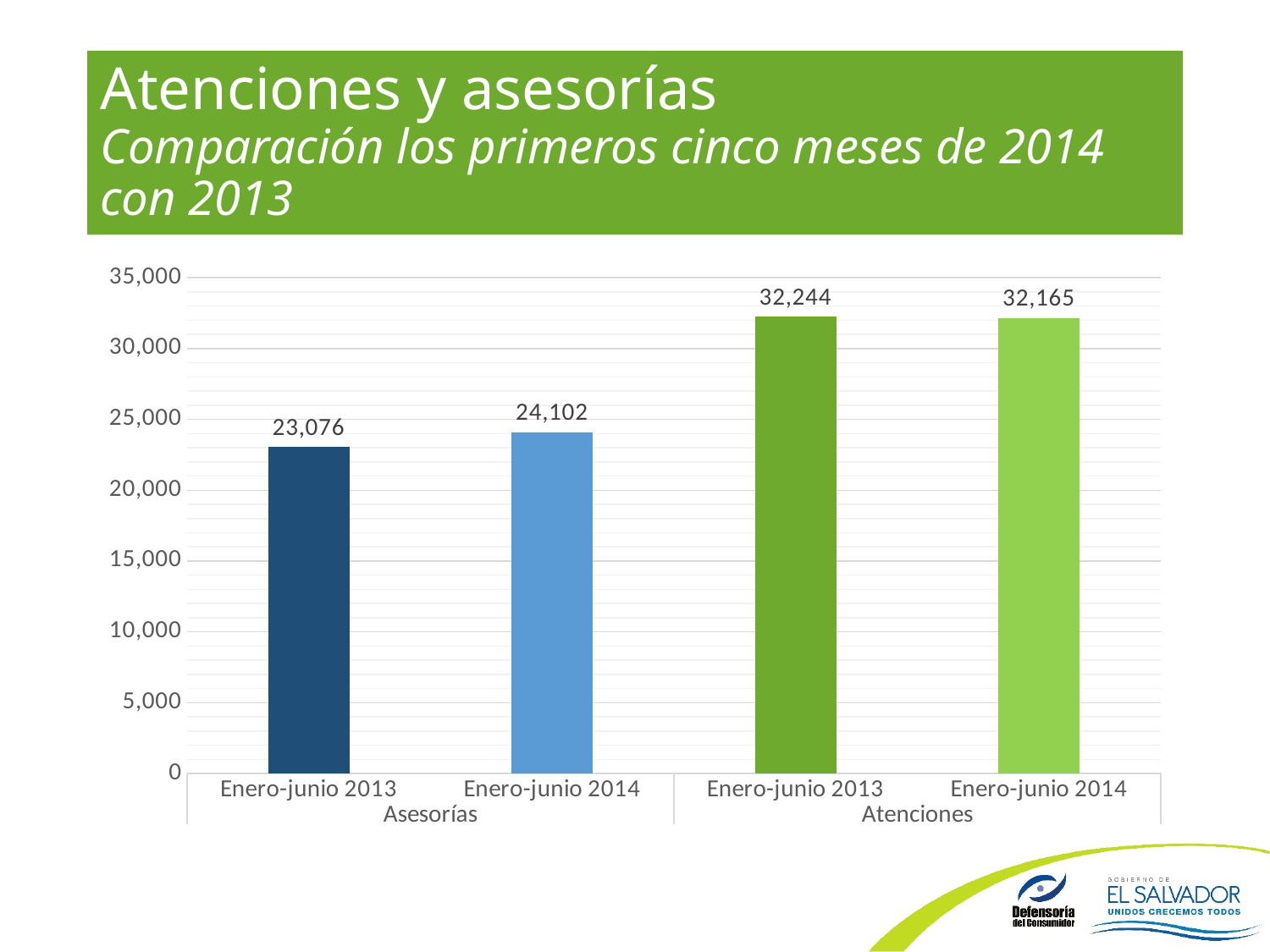
How many bars are plotted in the chart? 4 What is the difference between Atenciones in Enero-junio 2013 and Enero-junio 2014? 79 Which is larger: Asesorías in Enero-junio 2014 or Atenciones in Enero-junio 2014? Atenciones in Enero-junio 2014 Which bar has the lowest value? Asesorías, Enero-junio 2013 What is the value for Atenciones in Enero-junio 2014? 32,165 What is the value for Asesorías in Enero-junio 2013? 23,076 What are the two groups labelled on the x axis? Asesorías and Atenciones Which bar has the highest value? Atenciones, Enero-junio 2013 What is the value for Atenciones in Enero-junio 2013? 32,244 What is the difference between Asesorías in Enero-junio 2014 and Enero-junio 2013? 1,026 What is the value for Asesorías in Enero-junio 2014? 24,102 What kind of chart is shown on the slide? Bar chart